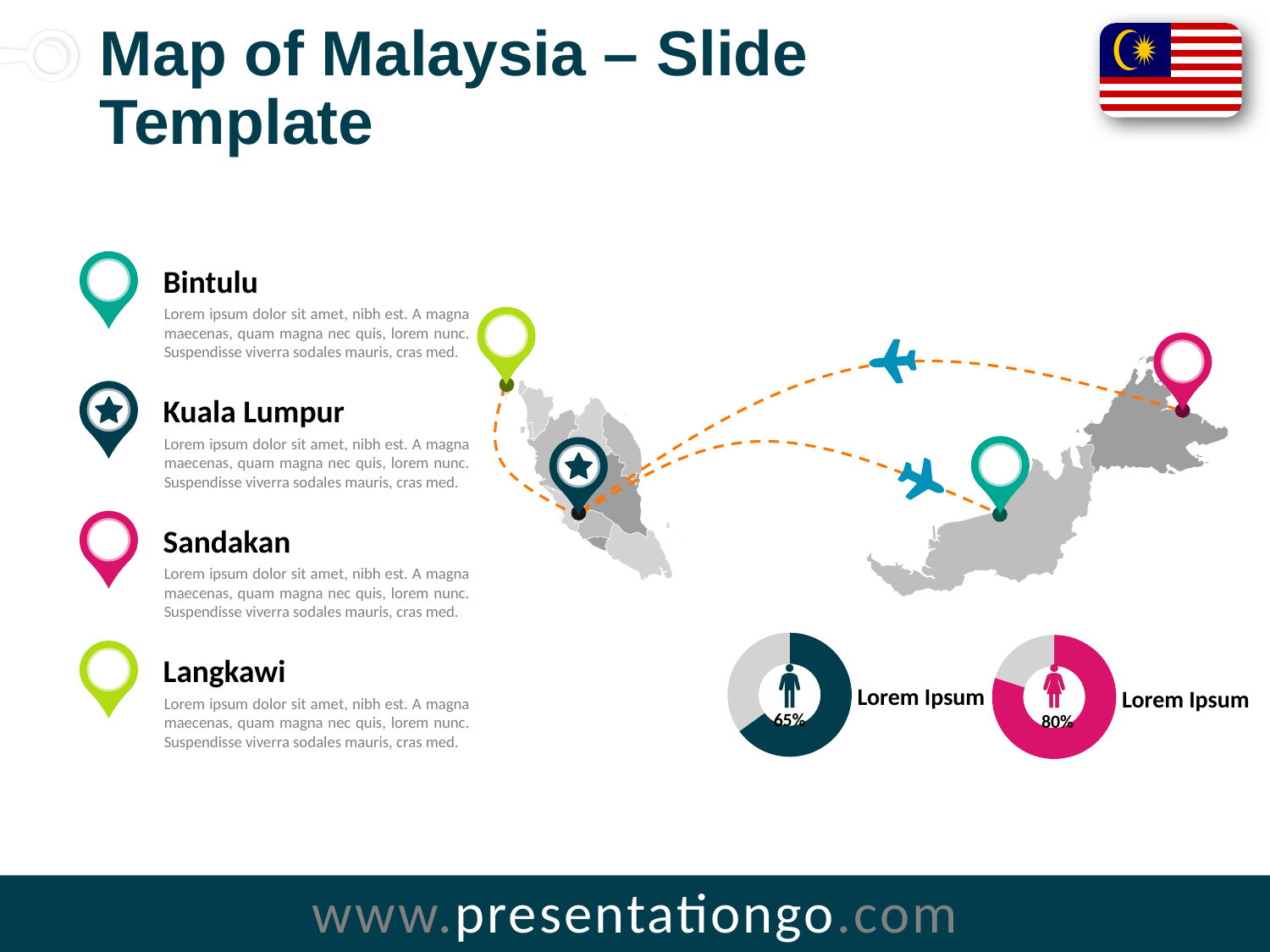
Is the value in the left donut chart greater or less than 50%? greater Which of the two donut charts shows the smaller percentage, the left one or the right one? the left one Is the value in the right donut chart greater or less than 75%? greater What value is shown in the right donut chart at the bottom of the slide? 80% What kind of chart is used to display the 65% and 80% values at the bottom of the slide? donut chart What value is shown in the left donut chart at the bottom of the slide? 65% How many donut charts are shown on the slide? 2 What label appears next to the left donut chart? Lorem Ipsum What is the difference in percentage points between the right donut chart's value and the left donut chart's value? 15 What colour is the filled portion of the right donut chart? pink Which of the two donut charts shows the larger percentage, the left one or the right one? the right one